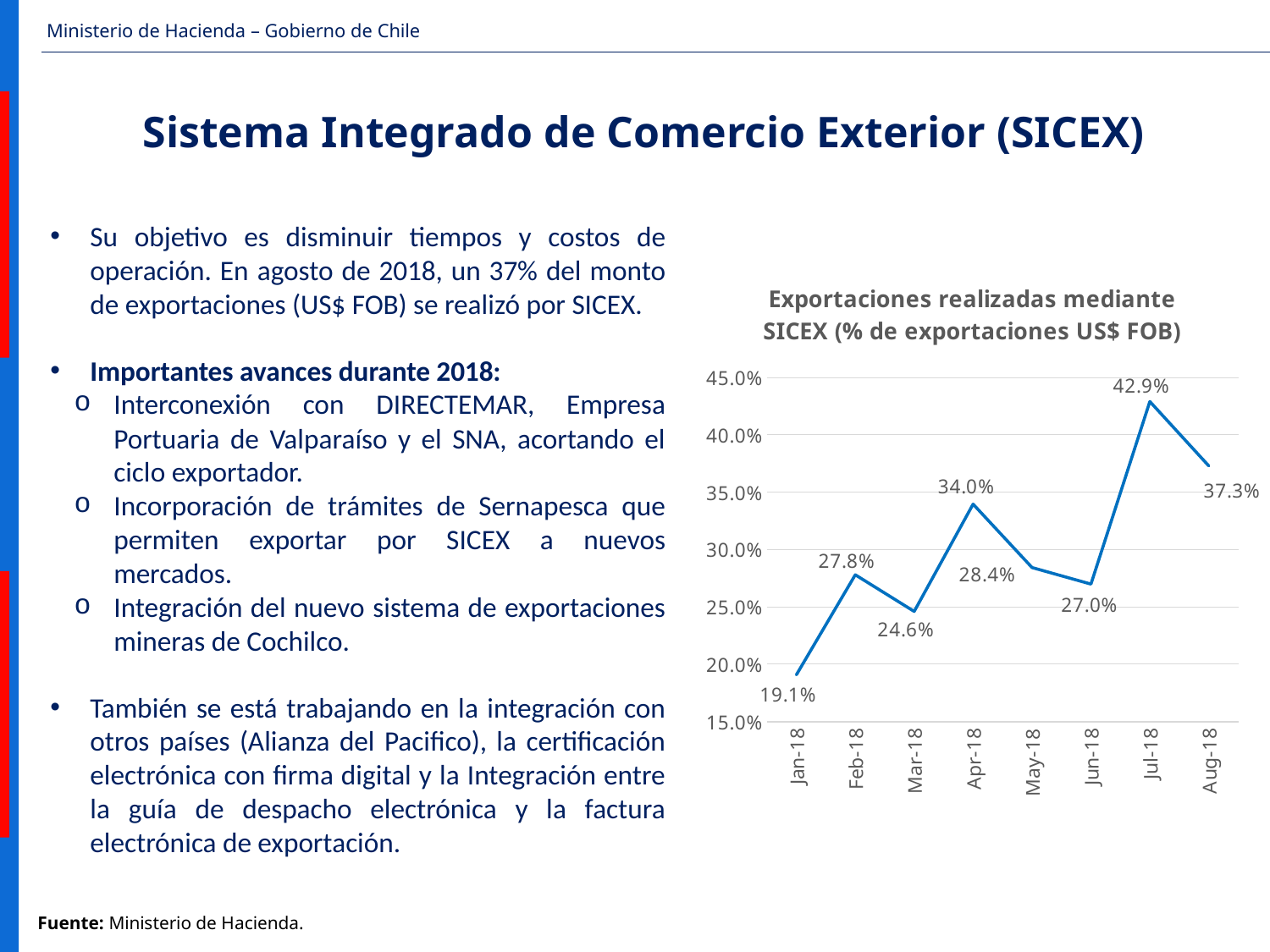
Which month has the highest value? Jul-18 Which is larger, the value for Feb-18 or the value for Mar-18? Feb-18 Is the value for May-18 greater or less than 30.0%? less What is the value for Apr-18? 34.0% What is the value for Jan-18? 19.1% What is the value for Aug-18? 37.3% Which month has the lowest value? Jan-18 What kind of chart is shown? line chart What is the value for Jul-18? 42.9% How many months are plotted on the chart? 8 What is the difference between the values for Jul-18 and Aug-18? 5.6% What is the title of the chart? Exportaciones realizadas mediante SICEX (% de exportaciones US$ FOB)